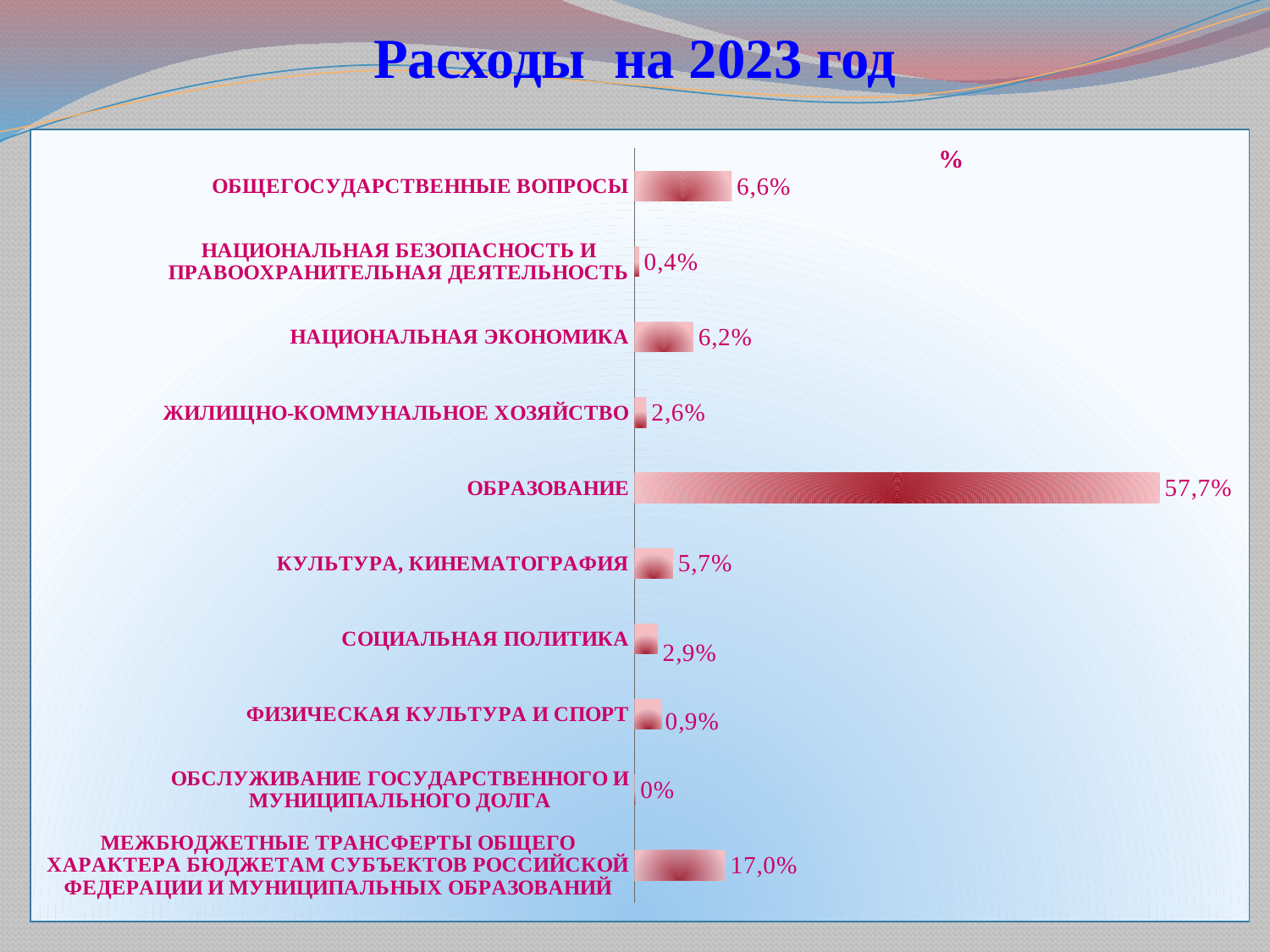
What is the value for НАЦИОНАЛЬНАЯ ЭКОНОМИКА? 6,2% Which category has the highest value? ОБРАЗОВАНИЕ How many categories are shown in the chart? 10 What is the difference between the values for ОБРАЗОВАНИЕ and МЕЖБЮДЖЕТНЫЕ ТРАНСФЕРТЫ ОБЩЕГО ХАРАКТЕРА БЮДЖЕТАМ СУБЪЕКТОВ РОССИЙСКОЙ ФЕДЕРАЦИИ И МУНИЦИПАЛЬНЫХ ОБРАЗОВАНИЙ? 40,7% What kind of chart is shown on the slide? bar chart Which category has the lowest value? ОБСЛУЖИВАНИЕ ГОСУДАРСТВЕННОГО И МУНИЦИПАЛЬНОГО ДОЛГА What is the value for ОБРАЗОВАНИЕ? 57,7% What is the difference between the values for ОБЩЕГОСУДАРСТВЕННЫЕ ВОПРОСЫ and НАЦИОНАЛЬНАЯ ЭКОНОМИКА? 0,4% What is the value for ФИЗИЧЕСКАЯ КУЛЬТУРА И СПОРТ? 0,9% Which is larger, the value for СОЦИАЛЬНАЯ ПОЛИТИКА or the value for ЖИЛИЩНО-КОММУНАЛЬНОЕ ХОЗЯЙСТВО? СОЦИАЛЬНАЯ ПОЛИТИКА What is the value for ОБЩЕГОСУДАРСТВЕННЫЕ ВОПРОСЫ? 6,6% What is the title of the slide? Расходы на 2023 год